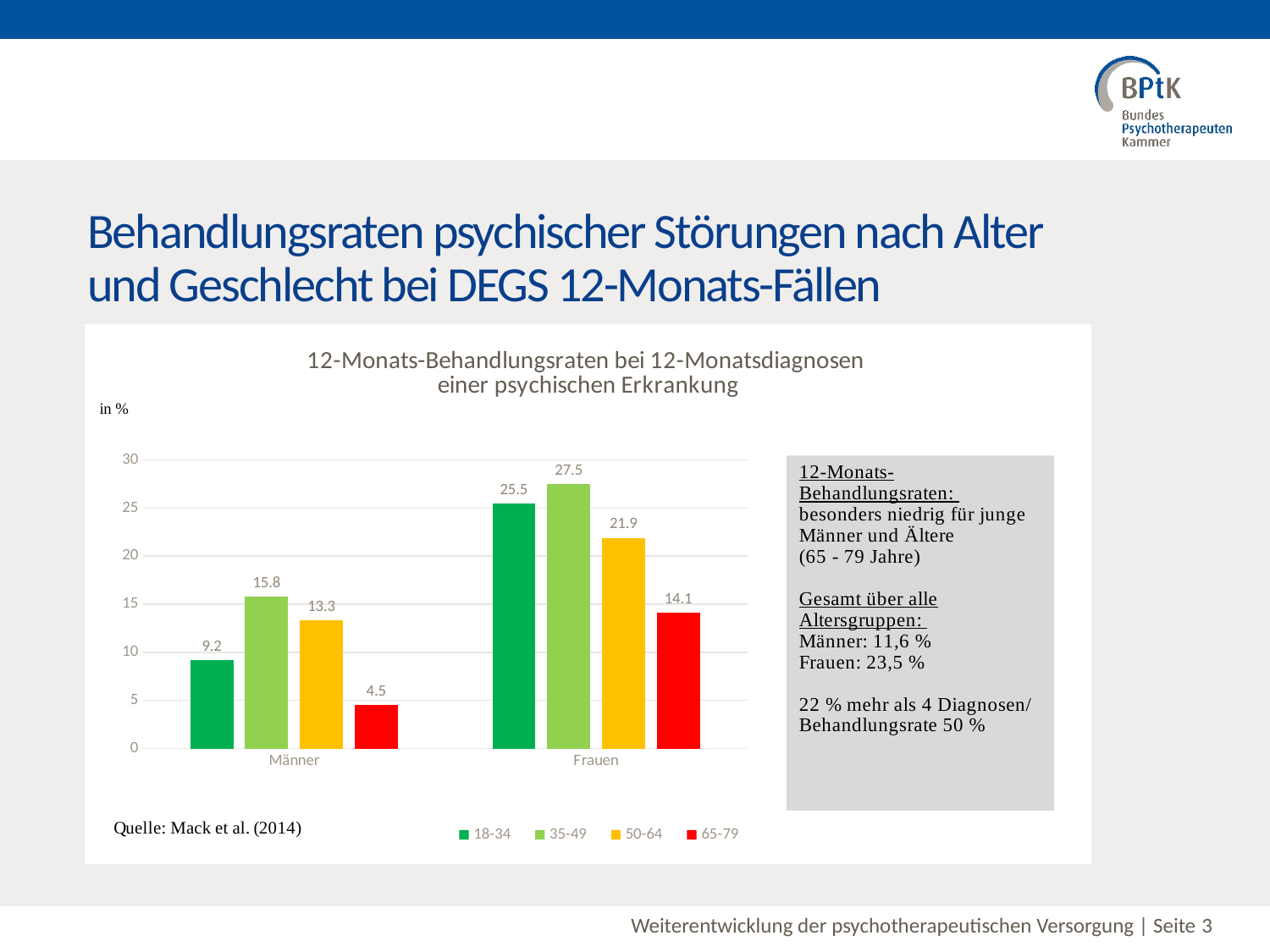
What is the value for the 35-49 age group among Frauen? 27.5 Which age group has the highest value among Frauen? 35-49 What kind of chart is shown on the slide? Bar chart What colour represents the 65-79 age group in the chart? Red What is the value for the 50-64 age group among Frauen? 21.9 Is the value for the 18-34 age group among Frauen greater or less than 25? greater What is the difference between the 35-49 values for Frauen and Männer? 11.7 What is the value for the 65-79 age group among Männer? 4.5 Which is larger: the 50-64 value for Männer or the 65-79 value for Frauen? 65-79 value for Frauen Which age group has the lowest value among Männer? 65-79 How many series does the legend list? 4 What is the value for the 18-34 age group among Männer? 9.2